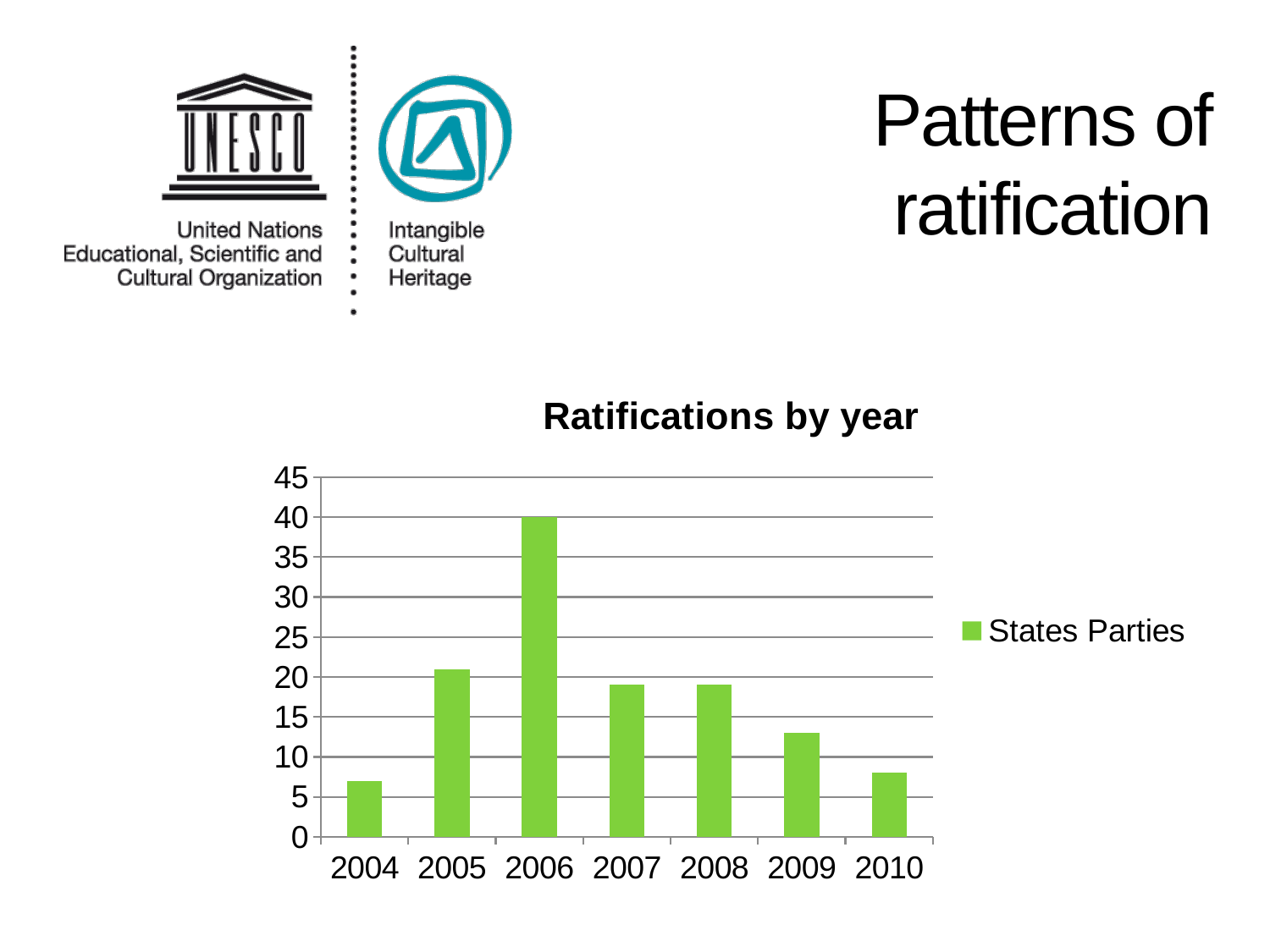
What is the value for 2006? 40 Which year has the highest number of ratifications? 2006 How many series does the legend list? 1 Do the values rise or fall from 2006 to 2010? fall Is the value for 2005 greater or less than 20? greater Is the value for 2009 greater or less than 15? less Is the value for 2004 greater or less than 10? less What is the title of the chart? Ratifications by year What series does the legend list? States Parties Which is larger, the value for 2005 or the value for 2009? 2005 How many years are shown on the x axis? 7 What kind of chart is shown on the slide? bar chart